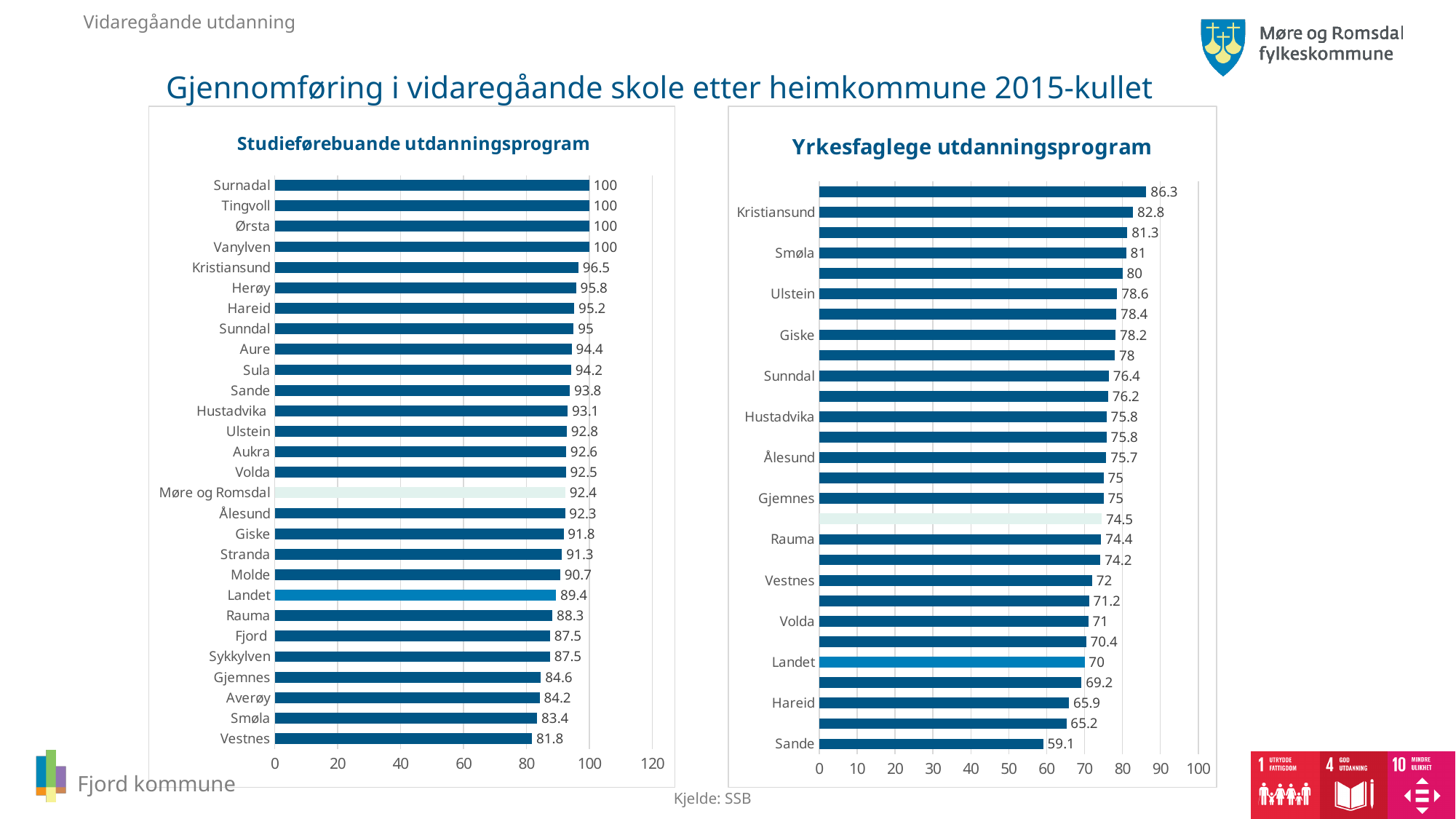
In the chart titled "Studieførebuande utdanningsprogram", what is the value for Kristiansund? 96.5 In the chart titled "Studieførebuande utdanningsprogram", how many categories have a value of 100? 4 What kind of chart is the chart titled "Yrkesfaglege utdanningsprogram"? Bar chart In the chart titled "Studieførebuande utdanningsprogram", what is the difference between the values for Møre og Romsdal and Landet? 3 In the chart titled "Studieførebuande utdanningsprogram", how many categories are plotted? 28 In the chart titled "Studieførebuande utdanningsprogram", what is the value for Landet? 89.4 In the chart titled "Yrkesfaglege utdanningsprogram", what is the value for Landet? 70 In the chart titled "Yrkesfaglege utdanningsprogram", what is the value for Sande? 59.1 In the chart titled "Studieførebuande utdanningsprogram", which category has the lowest value? Vestnes In the chart titled "Studieførebuande utdanningsprogram", which is larger, the value for Rauma or the value for Molde? Molde In the chart titled "Yrkesfaglege utdanningsprogram", what is the difference between the values for Kristiansund and Landet? 12.8 In the chart titled "Yrkesfaglege utdanningsprogram", what is the highest value shown? 86.3